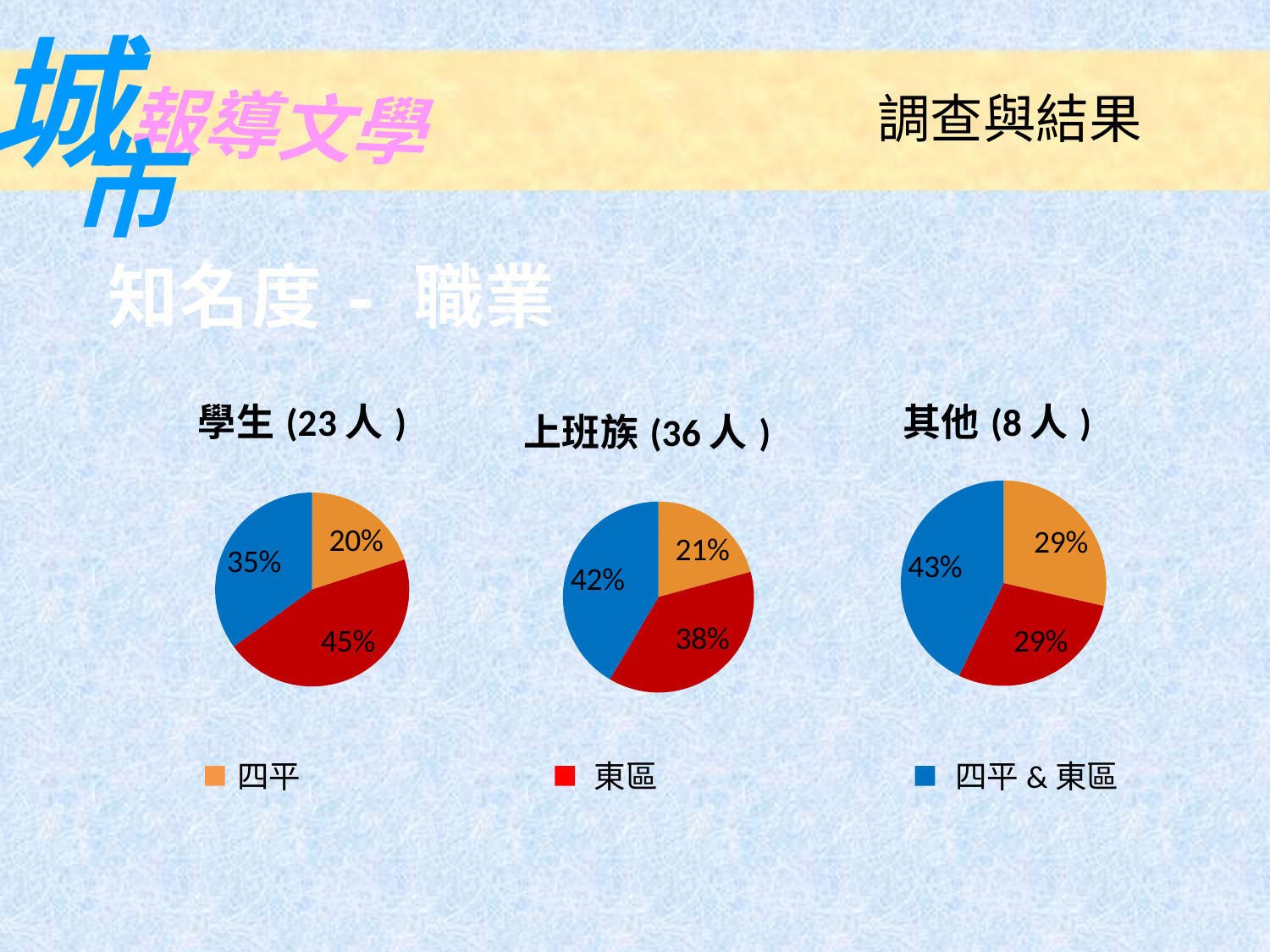
In the 上班族 (36 人) pie chart, which is larger, the 東區 slice or the 四平 & 東區 slice? 四平 & 東區 Which colour represents 東區 in the pie charts? Red In the 其他 (8 人) pie chart, what share is labelled for the 東區 slice? 29% How many slices does the 上班族 (36 人) pie chart have? 3 In the 學生 (23 人) pie chart, what share is labelled for the 四平 slice? 20% What kind of chart is used for the 學生 (23 人) data? Pie chart How many entries does the shared legend below the pie charts list? 3 In the 學生 (23 人) pie chart, which category has the largest slice? 東區 In the 學生 (23 人) pie chart, what is the difference between the 東區 share and the 四平 share? 25% In the 上班族 (36 人) pie chart, what share is labelled for the 四平 & 東區 slice? 42% In the 上班族 (36 人) pie chart, which category has the smallest slice? 四平 In the 其他 (8 人) pie chart, what share is labelled for the 四平 & 東區 slice? 43%